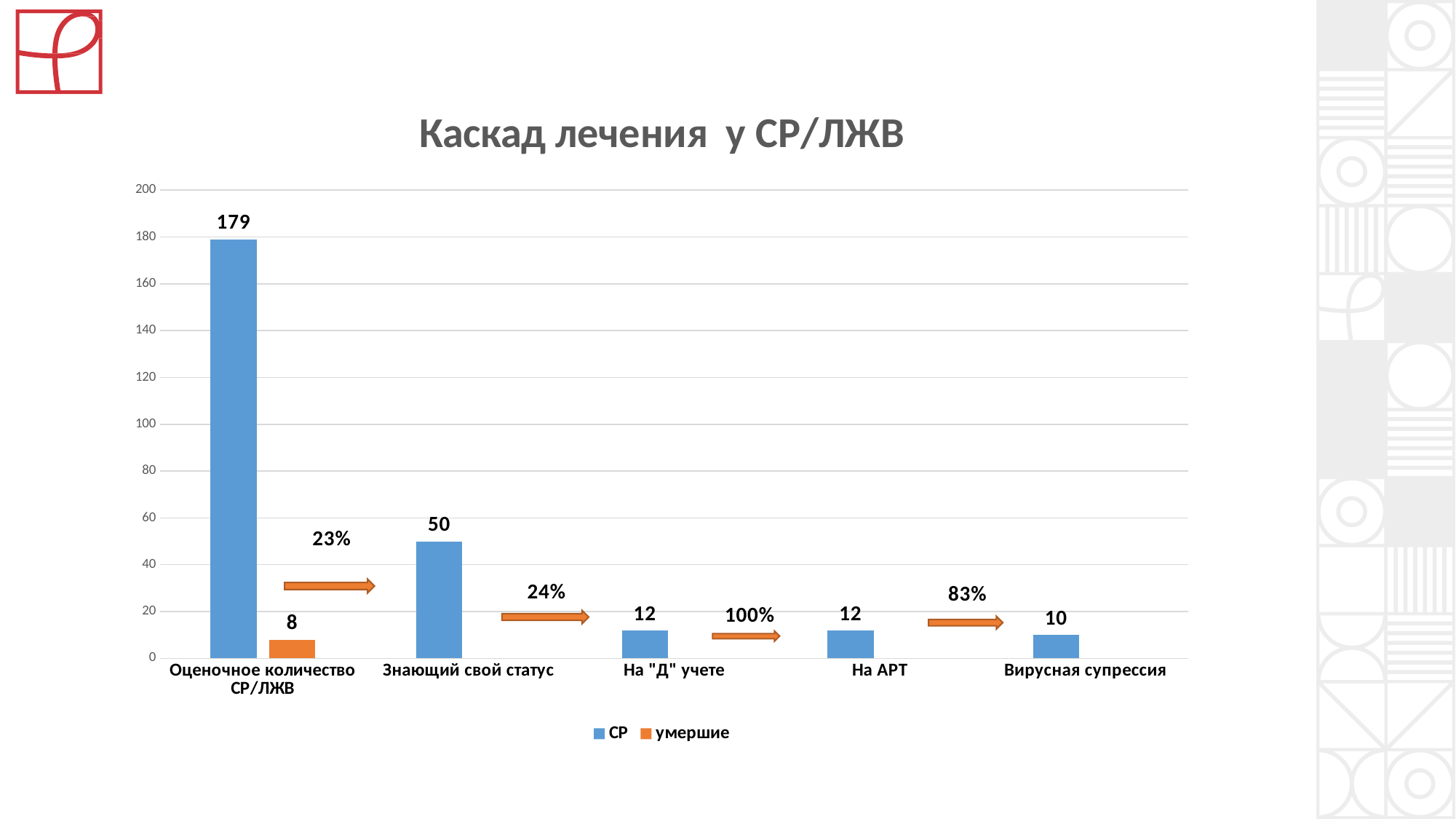
How many series does the legend list? 2 What is the title of the chart? Каскад лечения у СР/ЛЖВ How many categories are shown on the x axis? 5 What is the value for "Вирусная супрессия"? 10 What is the value for "Знающий свой статус"? 50 Which is larger: the value for "На АРТ" or the value for "Вирусная супрессия"? На АРТ What kind of chart is shown on the slide? Bar chart What is the value of the СР series for "Оценочное количество СР/ЛЖВ"? 179 What is the value of the умершие series for "Оценочное количество СР/ЛЖВ"? 8 Which category has the lowest СР value? Вирусная супрессия What is the difference between the СР values for "Оценочное количество СР/ЛЖВ" and "Знающий свой статус"? 129 Which category has the highest СР value? Оценочное количество СР/ЛЖВ